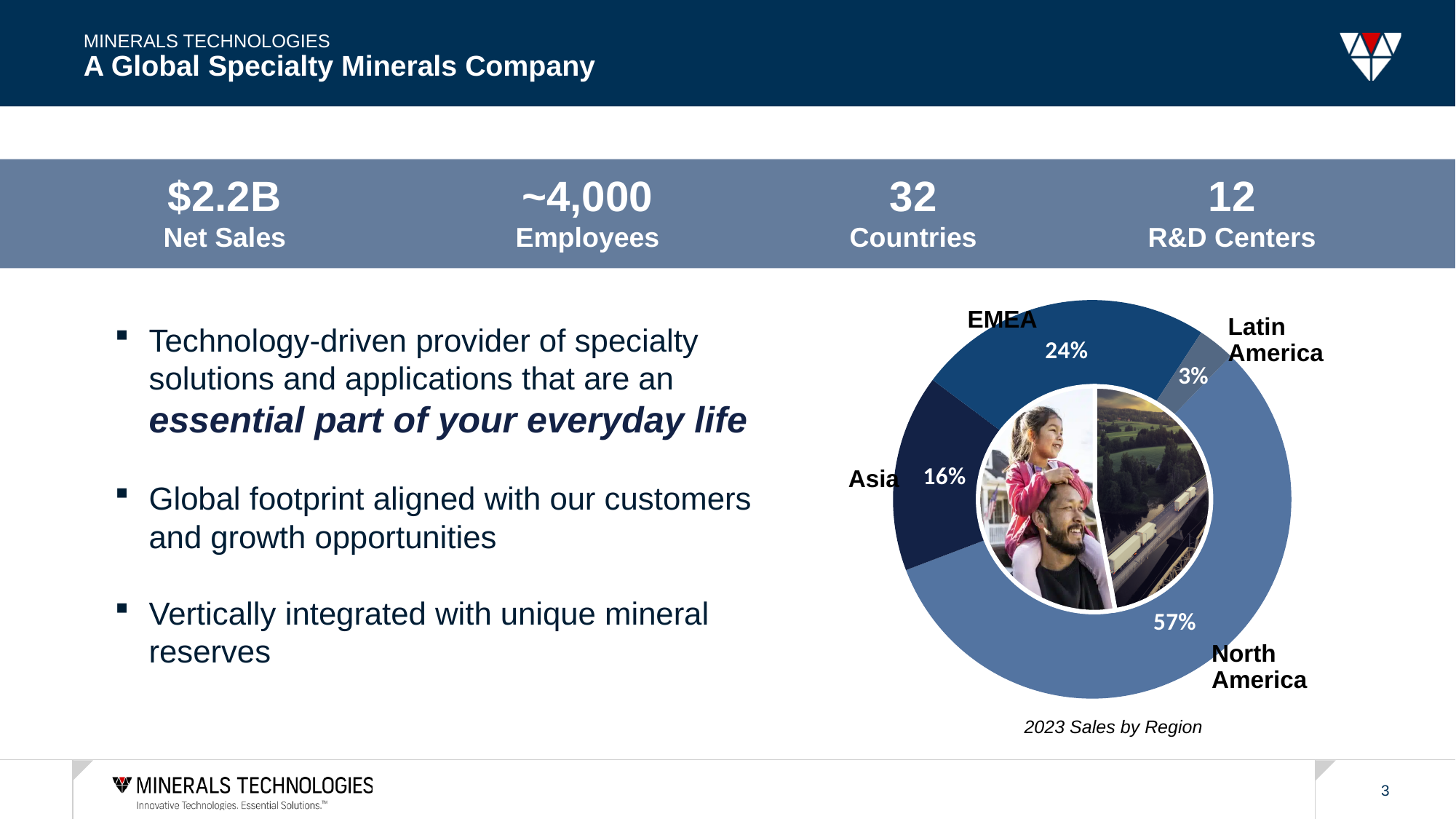
How many regions are shown in the 2023 Sales by Region pie chart? 4 What share of 2023 sales does North America account for in the pie chart? 57% Which region has the smallest share of 2023 sales in the pie chart? Latin America Which region has a larger share of 2023 sales, Asia or EMEA? EMEA What share of 2023 sales does Latin America account for in the pie chart? 3% What is the caption below the pie chart? 2023 Sales by Region What is the difference in percentage points between North America's and EMEA's shares of 2023 sales? 33 What share of 2023 sales does Asia account for in the pie chart? 16% What is the difference in percentage points between EMEA's and Asia's shares of 2023 sales? 8 Which region has the largest share of 2023 sales in the pie chart? North America What type of chart is used to show 2023 Sales by Region? Doughnut chart What share of 2023 sales does EMEA account for in the pie chart? 24%